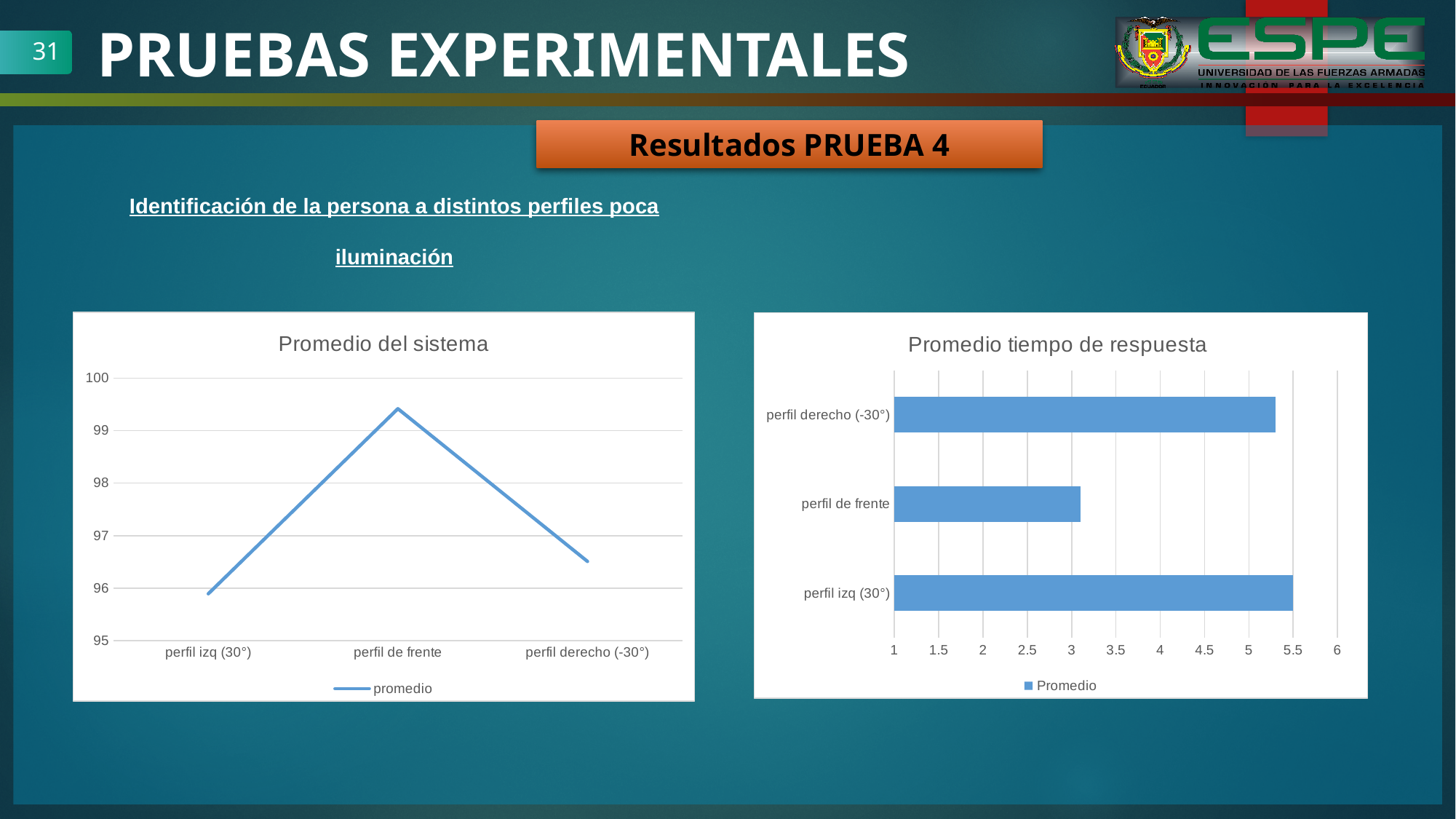
What kind of chart is the 'Promedio del sistema' chart on the left? line chart In the 'Promedio tiempo de respuesta' chart, how many bars are there? 3 In the 'Promedio tiempo de respuesta' chart, is the value for perfil derecho (-30°) greater or less than 5? greater How many series does the legend of the 'Promedio tiempo de respuesta' chart list? 1 In the 'Promedio tiempo de respuesta' chart, which category has the lowest value? perfil de frente In the 'Promedio del sistema' chart, which category has the highest value? perfil de frente In the 'Promedio del sistema' chart, how many categories are shown on the x axis? 3 In the 'Promedio del sistema' chart, which category has the lowest value? perfil izq (30°) In the 'Promedio del sistema' chart, is the value for perfil de frente greater or less than 99? greater What kind of chart is the 'Promedio tiempo de respuesta' chart on the right? bar chart In the 'Promedio tiempo de respuesta' chart, is the value for perfil de frente greater or less than 4? less